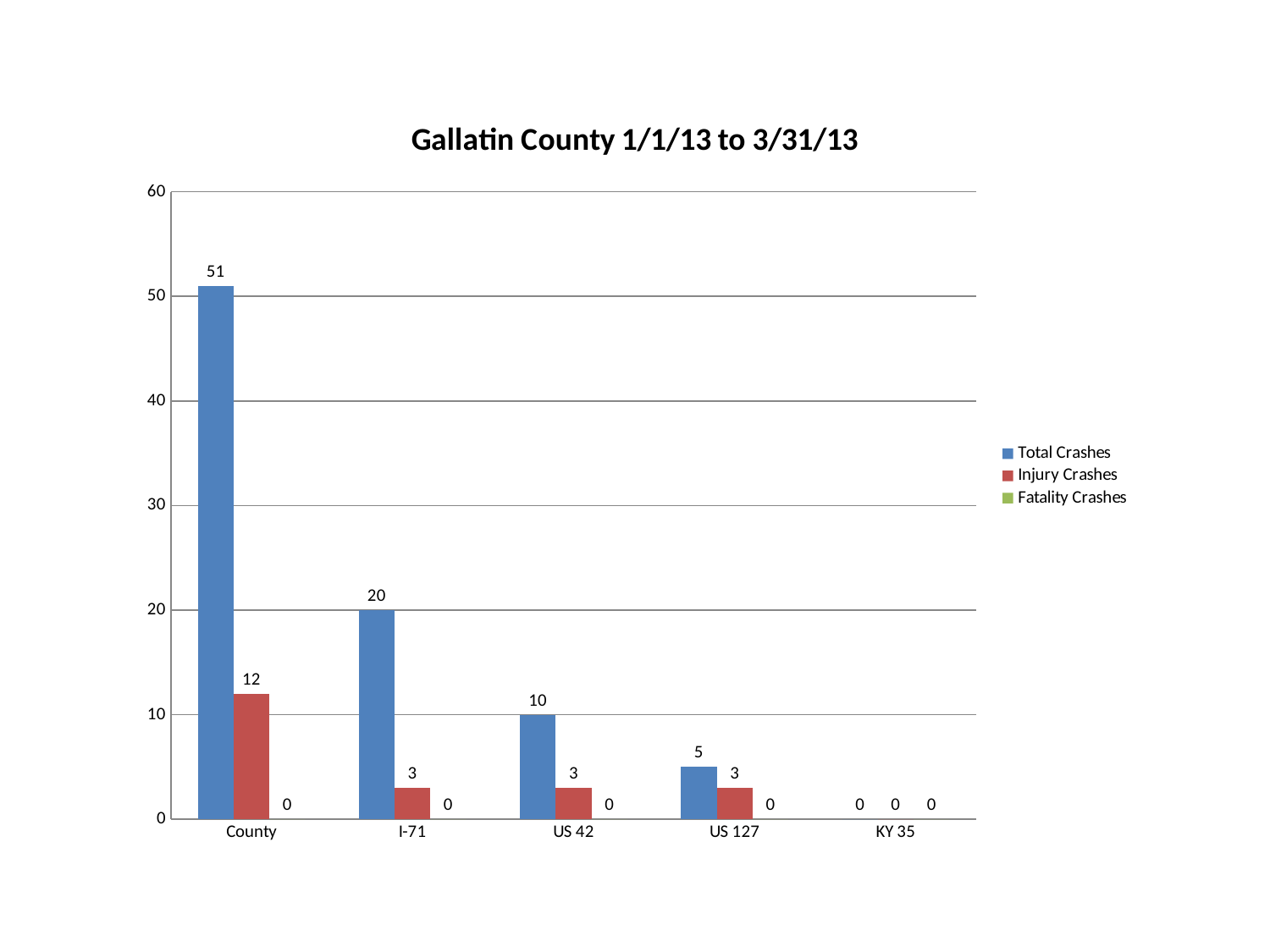
What is the number of Fatality Crashes for KY 35? 0 What is the number of Total Crashes for US 42? 10 What is the number of Total Crashes for County? 51 How many categories are shown on the x axis? 5 What is the number of Injury Crashes for I-71? 3 How many series does the legend list? 3 What is the difference between Total Crashes and Injury Crashes for County? 39 What kind of chart is shown on the slide? Bar chart What is the title of the chart? Gallatin County 1/1/13 to 3/31/13 Which category has the highest number of Total Crashes? County Which is larger, Total Crashes for I-71 or Total Crashes for US 127? I-71 Which category has the lowest number of Total Crashes? KY 35